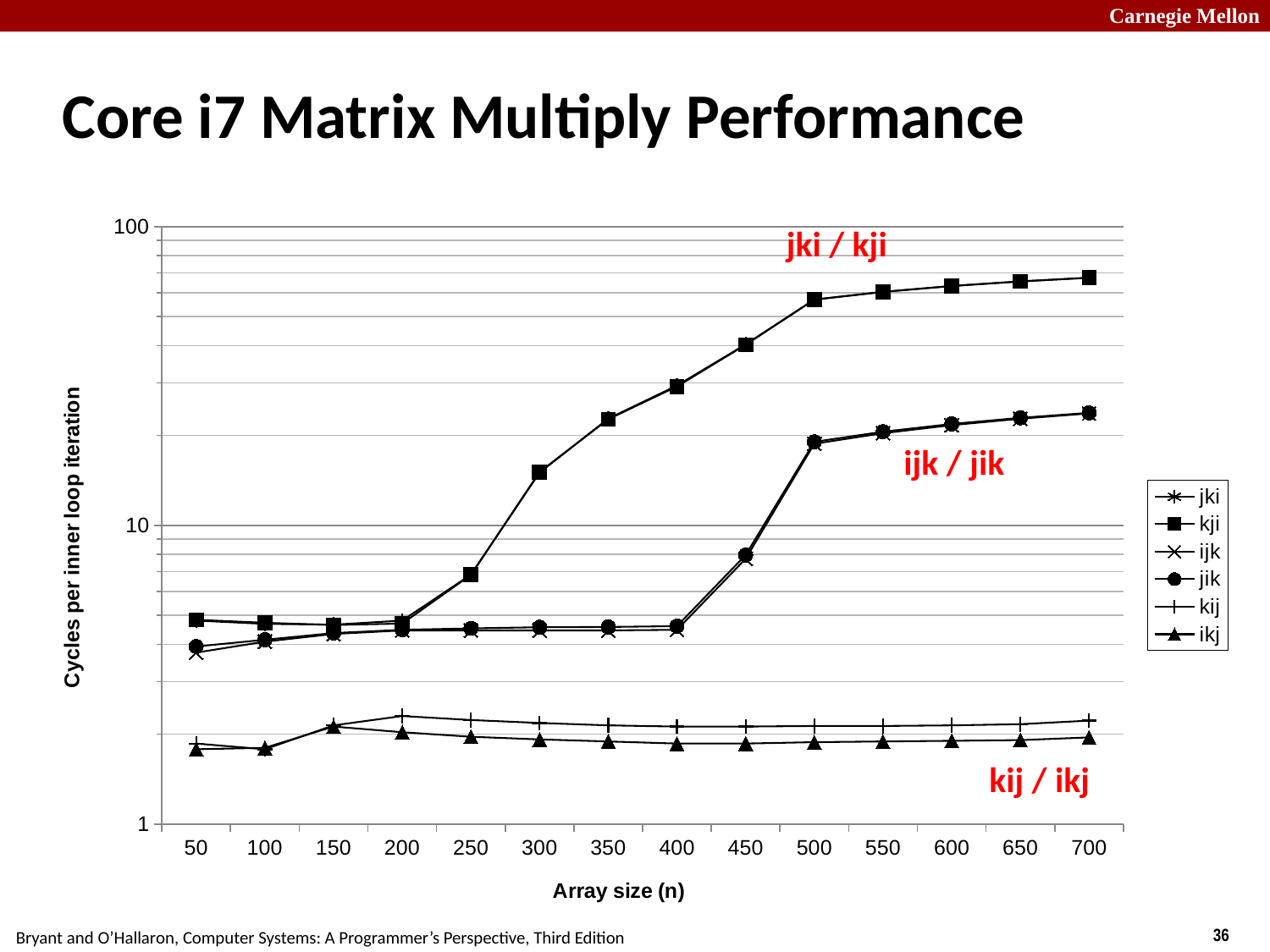
At array size 700, which is larger: the value for kji or the value for jik? kji Does the value for kji rise or fall as the array size increases from 200 to 500? rise How many series does the legend list? 6 Is the value for kji at array size 700 greater or less than 10? greater Is the value for jik at array size 400 greater or less than 10? less What kind of chart is shown on the slide? line chart How many array sizes are plotted along the x axis? 14 What is the label of the y axis? Cycles per inner loop iteration Which pair of series, as labelled in red on the chart, has the lowest cycles per inner loop iteration? kij / ikj Is the value for kij at array size 700 greater or less than 10? less Which pair of series, as labelled in red on the chart, has the highest cycles per inner loop iteration at large array sizes? jki / kji